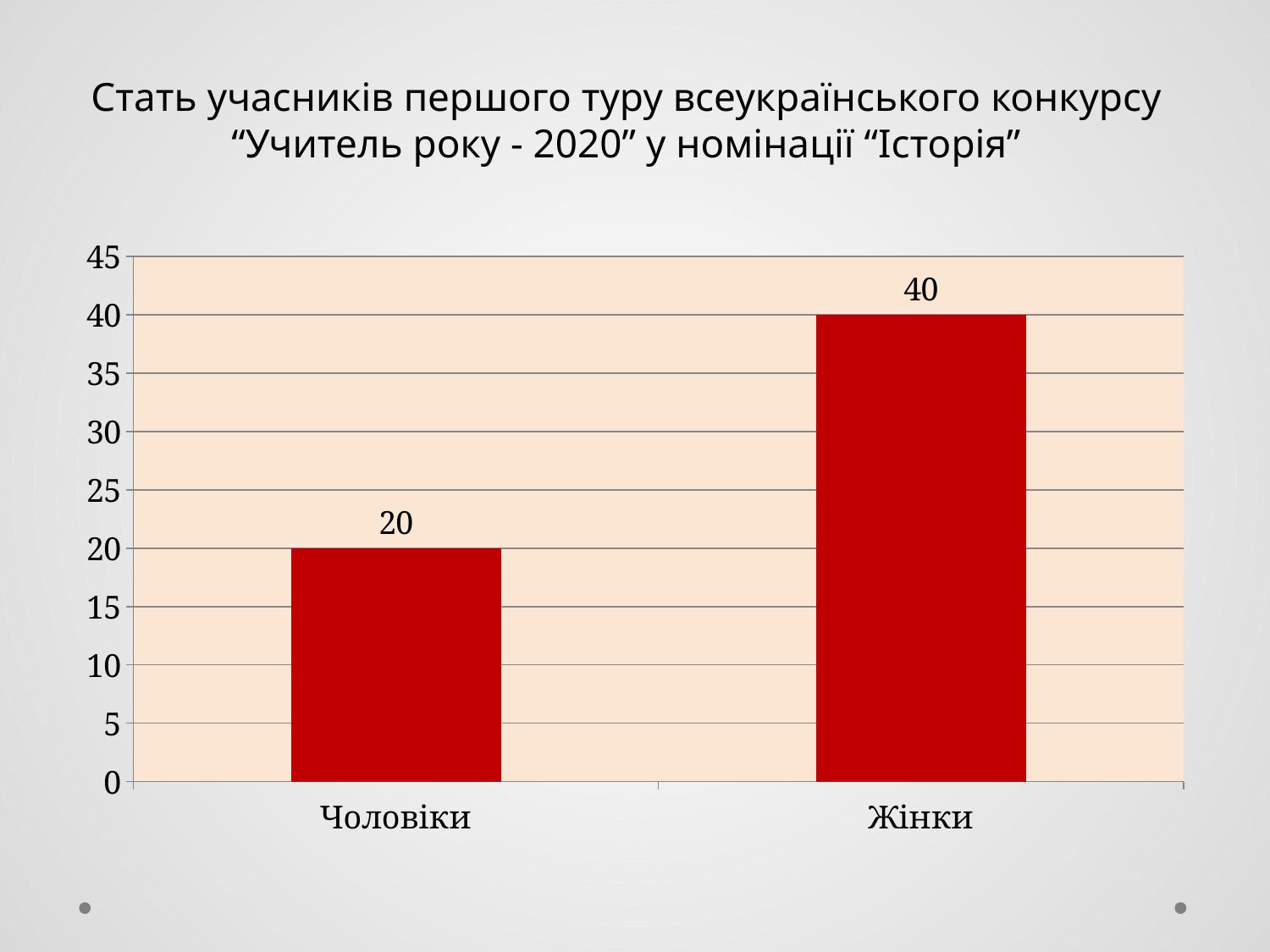
Which is larger, the value for Чоловіки or the value for Жінки? Жінки Which category has the lowest value? Чоловіки How many categories are shown on the x axis? 2 What is the value for Чоловіки? 20 Is the value for Жінки greater or less than 35? greater Which category has the highest value? Жінки What is the maximum value shown on the vertical axis? 45 Is the value for Чоловіки greater or less than 25? less What kind of chart is shown on the slide? bar chart What is the value for Жінки? 40 What colour are the bars in the chart? red What is the difference between the values for Жінки and Чоловіки? 20